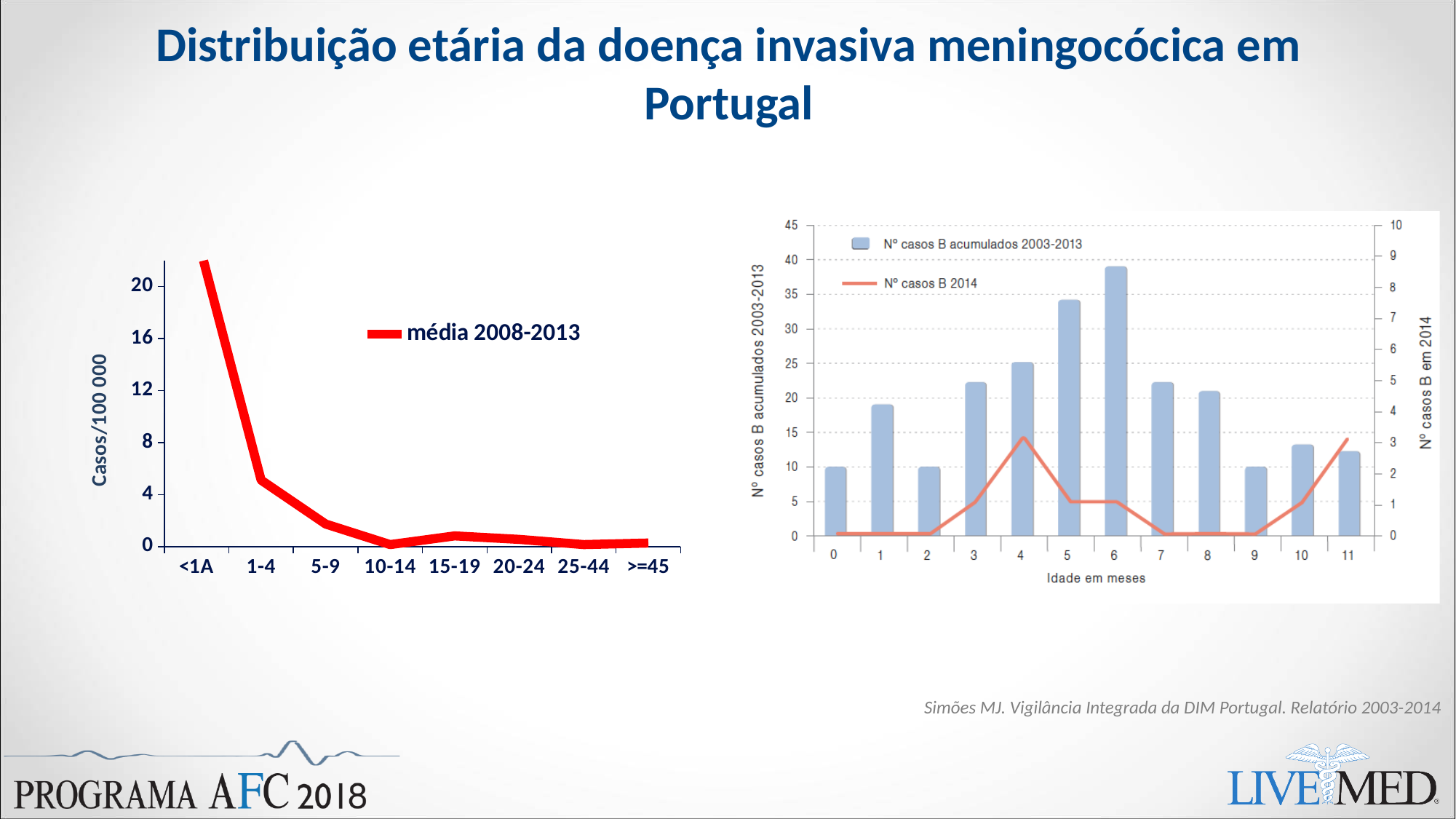
In the right chart, is the bar for month 6 (Nº casos B acumulados 2003-2013) greater or less than 35? greater In the left chart (média 2008-2013), is the value for 1-4 greater or less than 8? less What kind of chart is the left chart (média 2008-2013)? line chart In the left chart (média 2008-2013), which age group has the highest value? <1A In the left chart, do the values generally rise or fall as age increases along the x axis? fall How many series does the legend of the right chart list? 2 In the right chart, which bar is taller for Nº casos B acumulados 2003-2013: month 4 or month 5? month 5 How many age groups are shown on the x axis of the left chart? 8 In the right chart, which age in months has the highest bar for Nº casos B acumulados 2003-2013? 6 What is the y-axis label of the left chart? Casos/100 000 In the right chart, what is the x-axis title? Idade em meses In the left chart (média 2008-2013), is the value for <1A greater or less than 20? greater